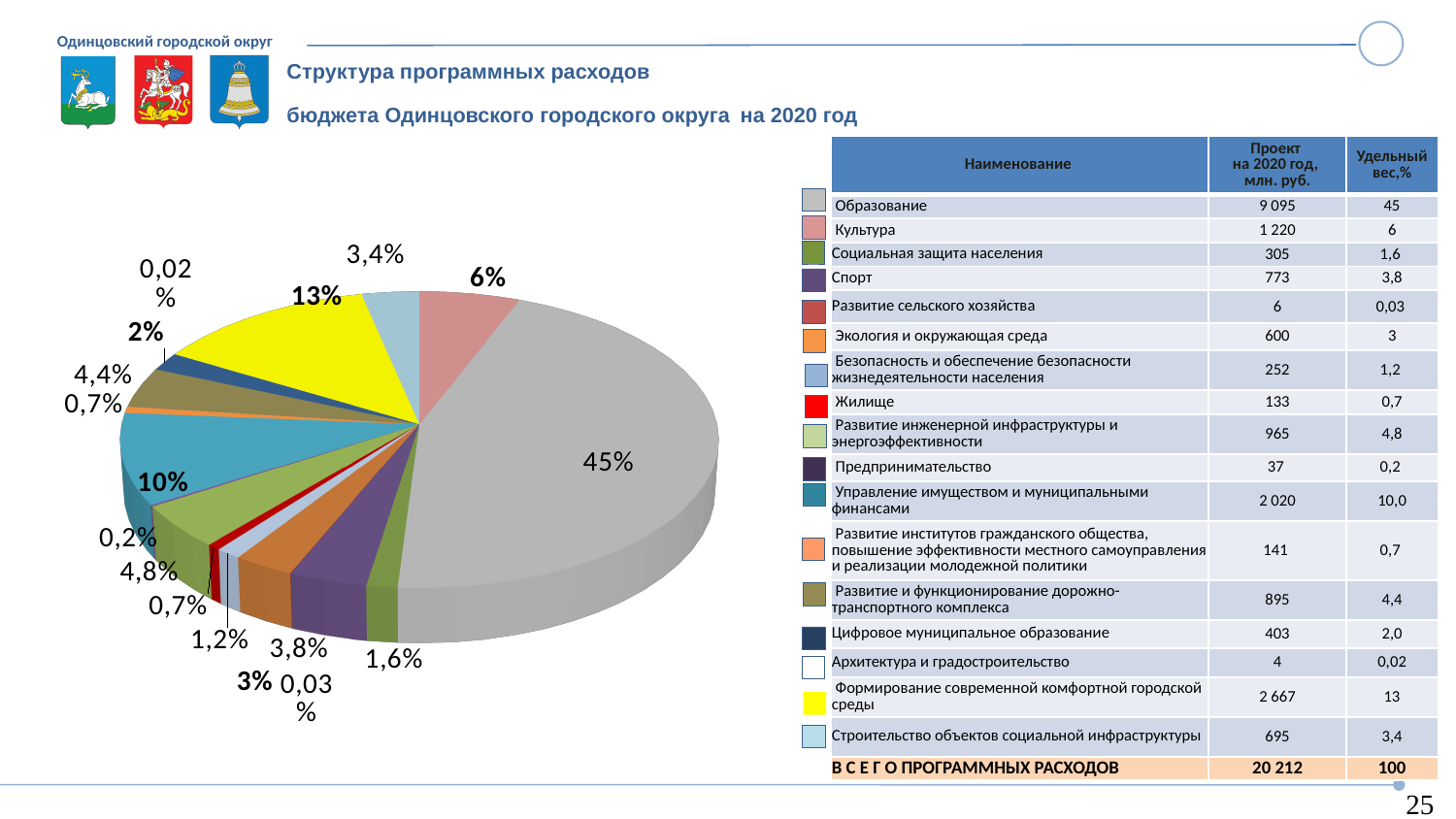
How many slices does the pie chart have? 17 What kind of chart is shown on the slide? pie chart What is the largest percentage label shown on the pie chart? 45% What share of the pie does the yellow slice for Формирование современной комфортной городской среды represent? 13% What is the title of the chart on the slide? Структура программных расходов бюджета Одинцовского городского округа на 2020 год What is the difference in percentage points between the 45% slice and the 13% slice? 32 What share of the pie does the slice for Культура represent? 6% Is the share for Спорт on the pie chart greater or less than 10%? less What share of the pie does the grey slice for Образование represent? 45% What is the smallest percentage label shown on the pie chart? 0,02% Which is larger on the pie chart: the slice labelled 13% or the slice labelled 10%? 13%